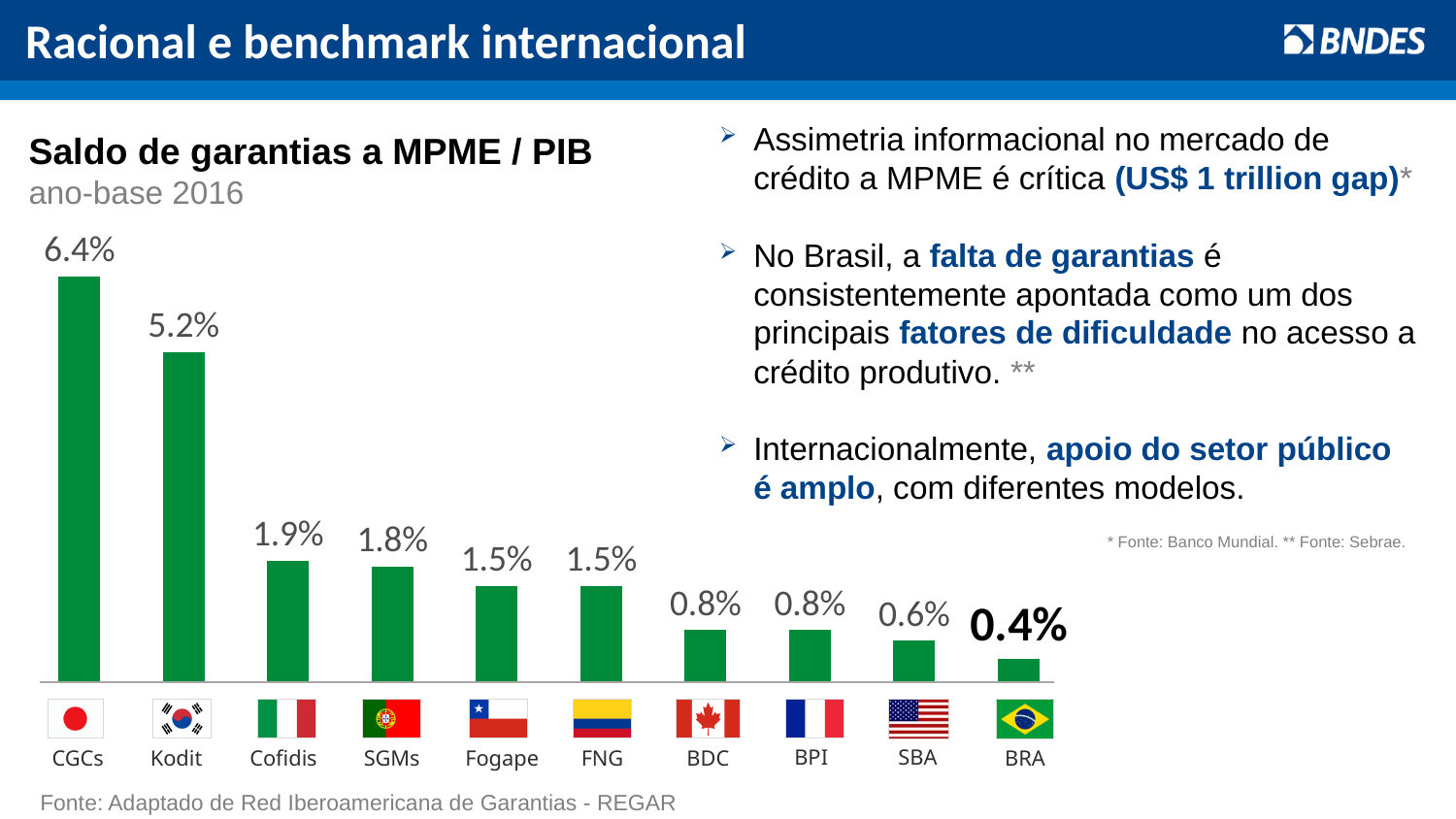
Which is larger, the value for SGMs or the value for BDC? SGMs What is the difference between the values for Cofidis and BRA? 1.5% What kind of chart is shown on the slide? Bar chart Which category has the lowest value? BRA Which category has the highest value? CGCs What is the value for SBA? 0.6% What is the value for BRA? 0.4% What is the title of the chart? Saldo de garantias a MPME / PIB What is the value for CGCs? 6.4% What is the value for Kodit? 5.2% What is the difference between the values for CGCs and Kodit? 1.2% How many categories are shown in the chart? 10